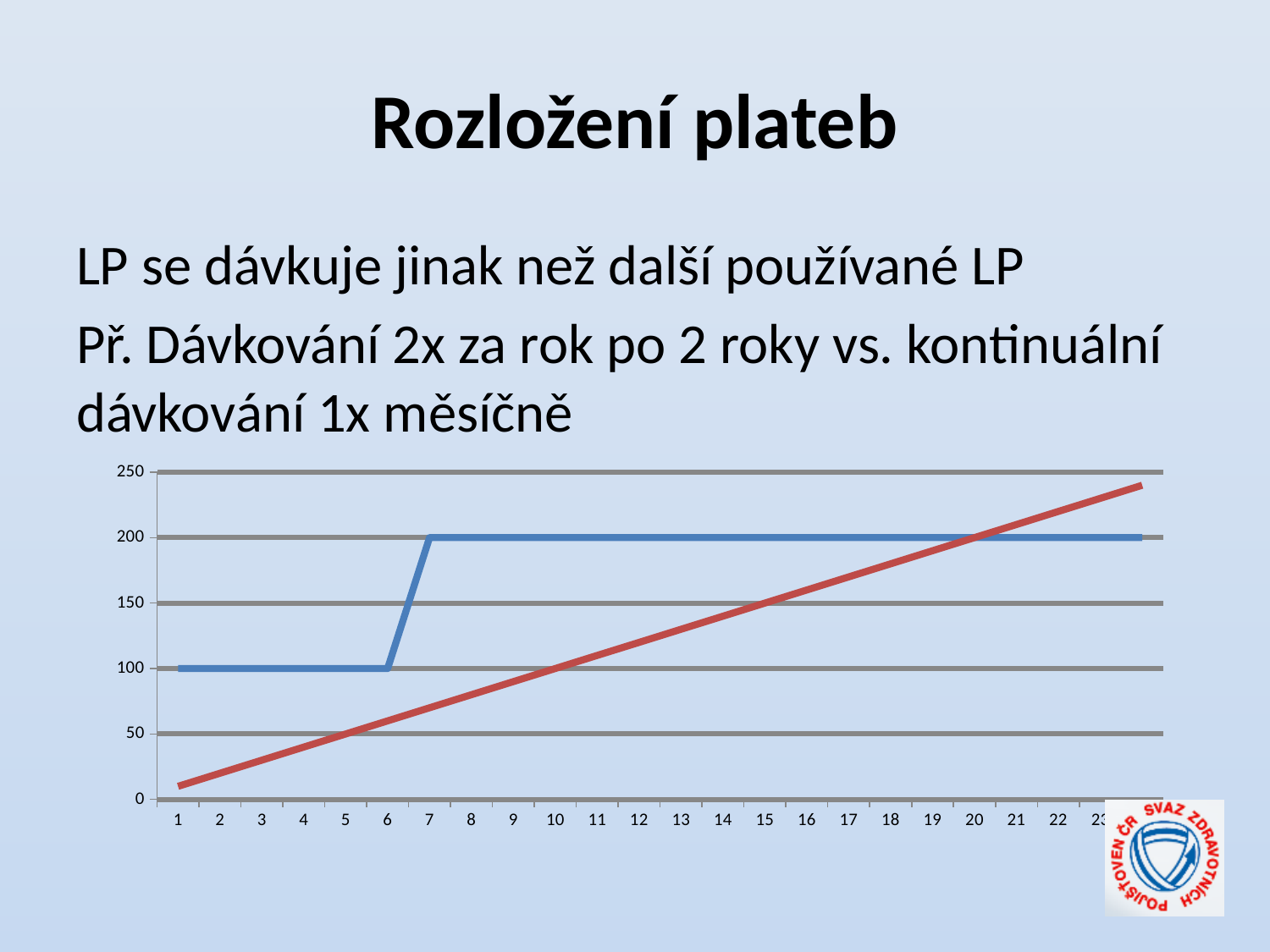
What is the value of the blue line at x = 12? 200 What kind of chart is shown on the slide? line chart At x = 23, which line has the higher value, the blue line or the red line? red line Does the red line rise or fall as x increases? rise At which x value does the blue line first reach 200? 7 Is the value of the red line at x = 22 greater or less than 200? greater Is the value of the blue line at x = 4 greater or less than 150? less At x = 3, which line has the higher value, the blue line or the red line? blue line Is the value of the red line at x = 3 greater or less than 50? less What colours are the two lines on the chart? blue and red What is the value of the blue line at x = 3? 100 How many lines are plotted on the chart? 2